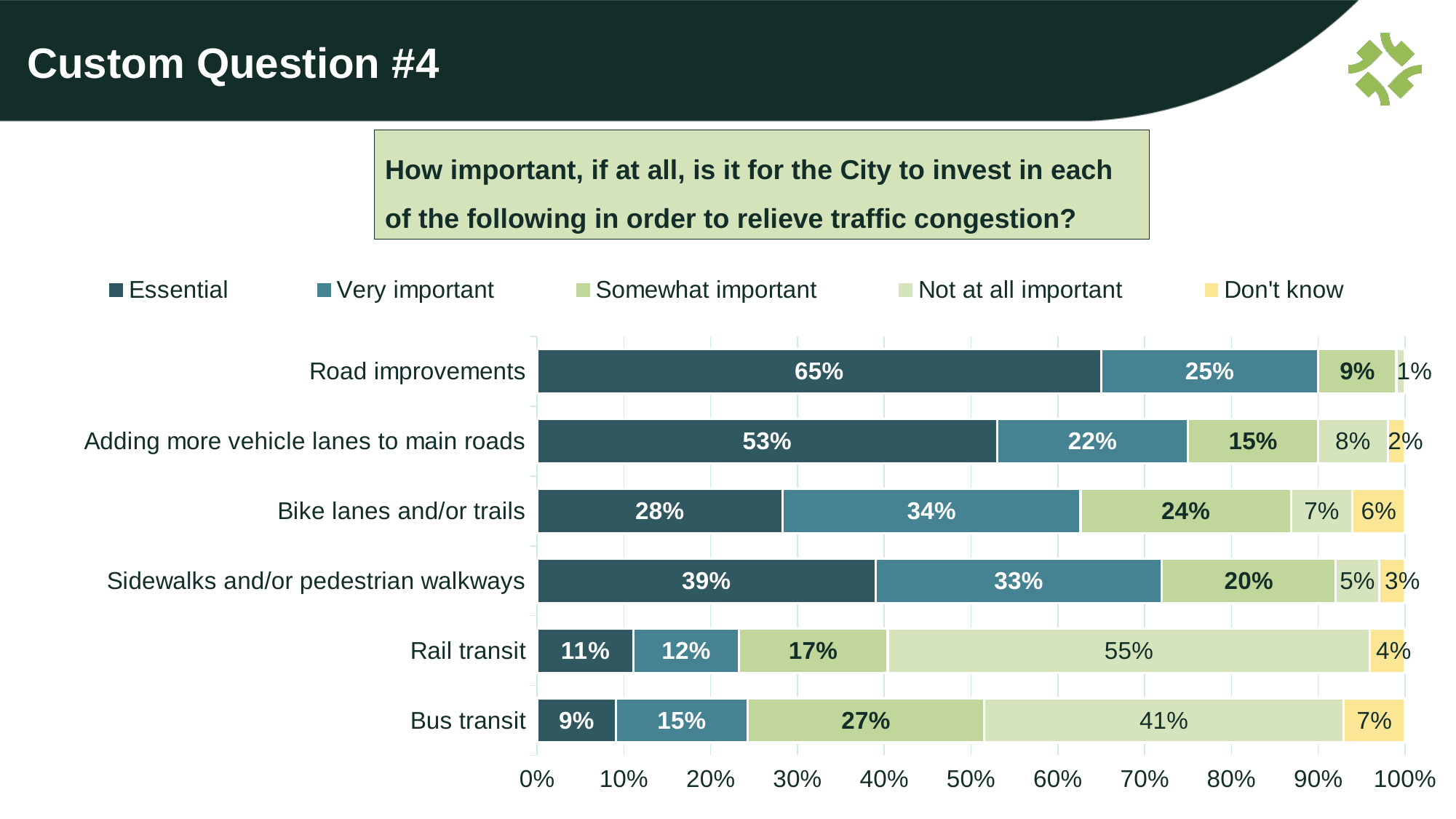
What is the combined Essential and Very important percentage for Sidewalks and/or pedestrian walkways? 72% Which has a larger Somewhat important value, Bus transit or Bike lanes and/or trails? Bus transit Which category has the lowest Essential percentage? Bus transit What kind of chart is shown on the slide? Stacked bar chart How many categories are shown on the chart? 6 Which category has the highest Essential percentage? Road improvements What is the Don't know value for Bike lanes and/or trails? 6% How many series does the legend list? 5 How many percentage points higher is the Essential value for Road improvements than for Adding more vehicle lanes to main roads? 12 percentage points What is the Not at all important value for Rail transit? 55% What is the Somewhat important value for Bus transit? 27% What percentage of respondents rated Road improvements as Essential? 65%